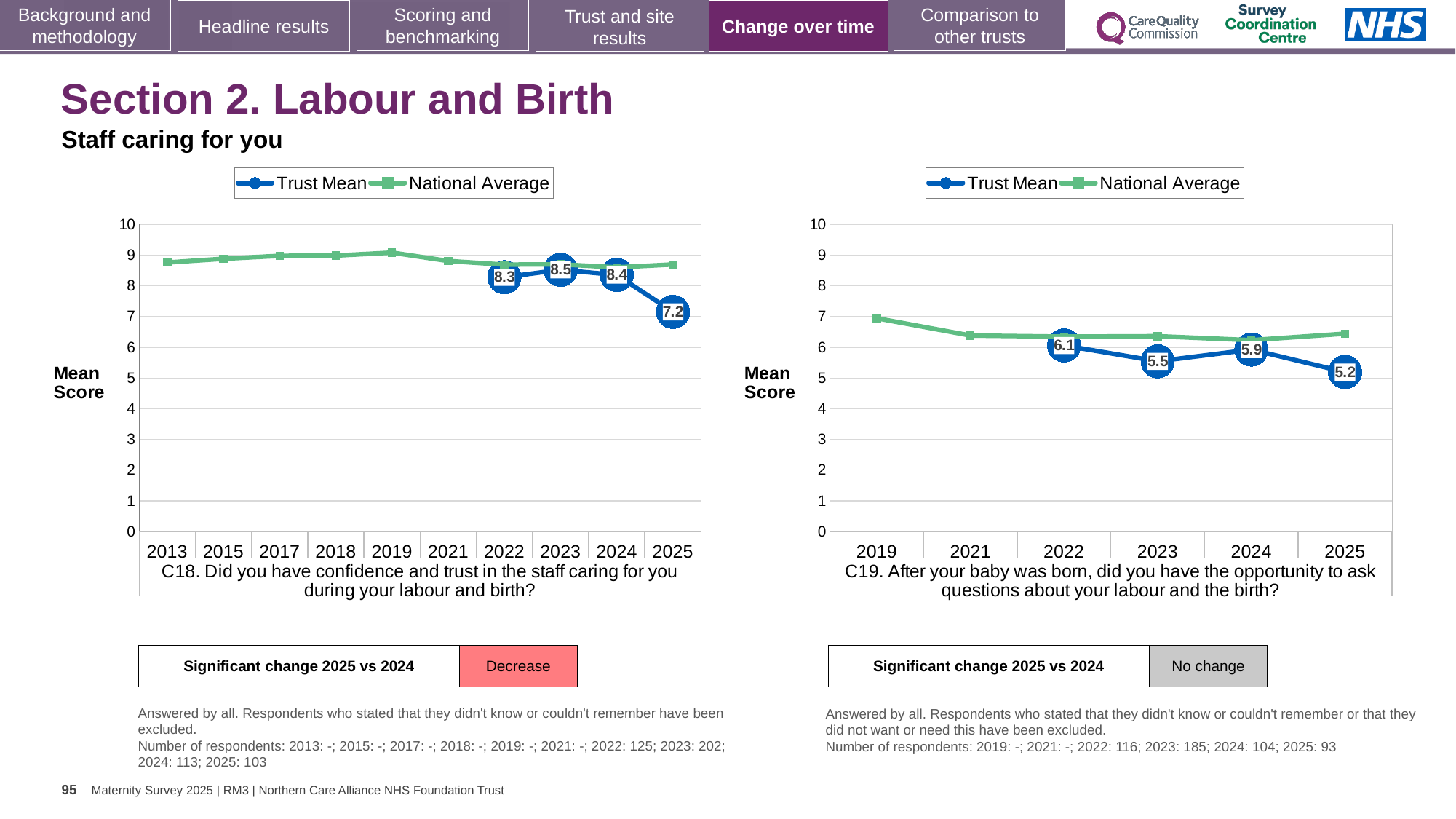
In the C19 chart (right), is the Trust Mean for 2024 or 2025 larger? 2024 In the C18 chart (left), which year has the lowest Trust Mean? 2025 In the C18 chart (left), what is the Trust Mean for 2025? 7.2 In the C18 chart (left), what is the Trust Mean for 2023? 8.5 In the C19 chart (right), what is the Trust Mean for 2025? 5.2 How many series does the legend of the C18 chart (left) list? 2 In the C19 chart (right), what is the Trust Mean for 2022? 6.1 In the C18 chart (left), is the National Average for 2019 greater or less than 8? greater In the C19 chart (right), what is the difference between the Trust Mean for 2022 and 2023? 0.6 In the C18 chart (left), what is the difference between the Trust Mean for 2024 and 2025? 1.2 How many years are shown on the x axis of the C19 chart (right)? 6 In the C19 chart (right), which year has the highest Trust Mean? 2022